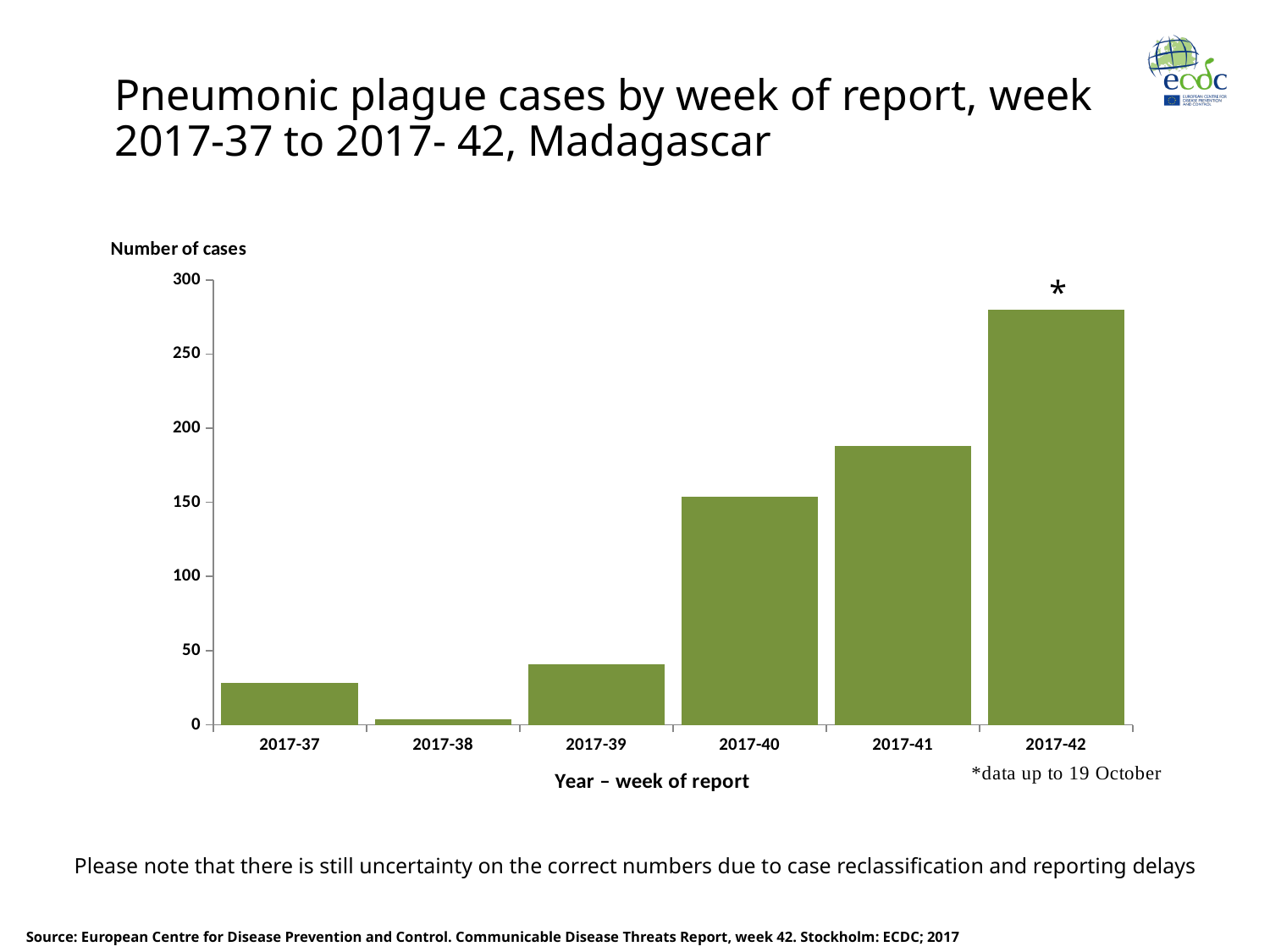
Is the number of cases for 2017-41 greater or less than 200? less What kind of chart is shown on the slide? bar chart From week 2017-38 to week 2017-42, do the number of cases rise or fall? rise How many weeks (categories) are shown on the x axis? 6 Is the number of cases for 2017-39 greater or less than 50? less Is the number of cases for 2017-42 greater or less than 250? greater Which week has the lowest number of cases? 2017-38 Which week has the highest number of cases? 2017-42 Which week has more cases, 2017-37 or 2017-39? 2017-39 Which week has more cases, 2017-40 or 2017-41? 2017-41 What is the label of the y axis? Number of cases